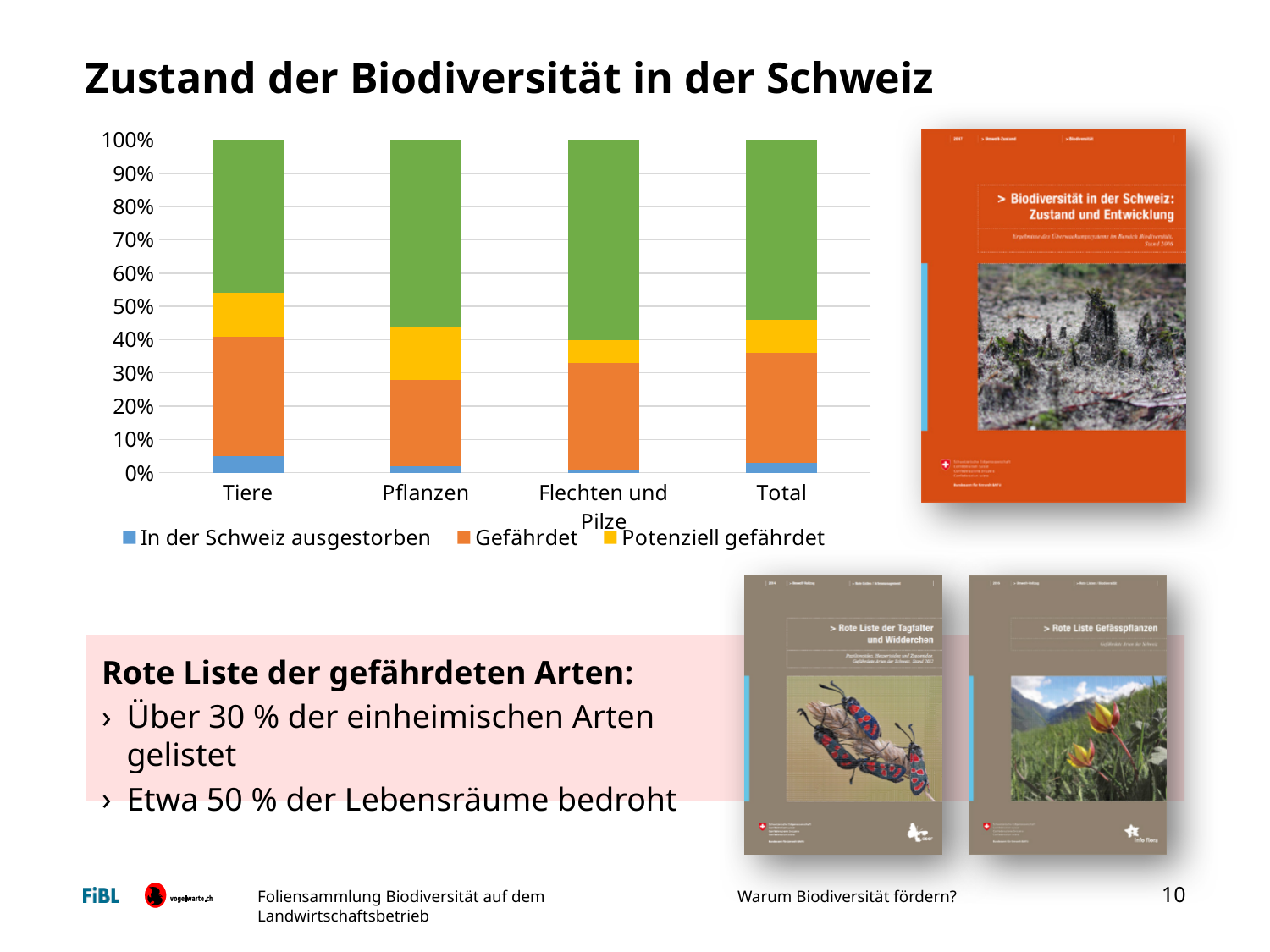
Is the 'Gefährdet' segment for Tiere greater or less than 30%? greater How many categories are shown on the x axis of the chart? 4 Is the combined share of the three legend categories for Tiere greater or less than 50%? greater How many series does the chart legend list? 3 Which has a larger 'In der Schweiz ausgestorben' segment, Tiere or Pflanzen? Tiere What is the title of the slide containing the chart? Zustand der Biodiversität in der Schweiz Is the combined share of the three legend categories for Pflanzen greater or less than 50%? less What kind of chart is shown on the slide? stacked bar chart Which legend entry is shown in orange? Gefährdet Which category has the smallest 'Gefährdet' segment? Pflanzen Which category has the largest 'In der Schweiz ausgestorben' segment? Tiere